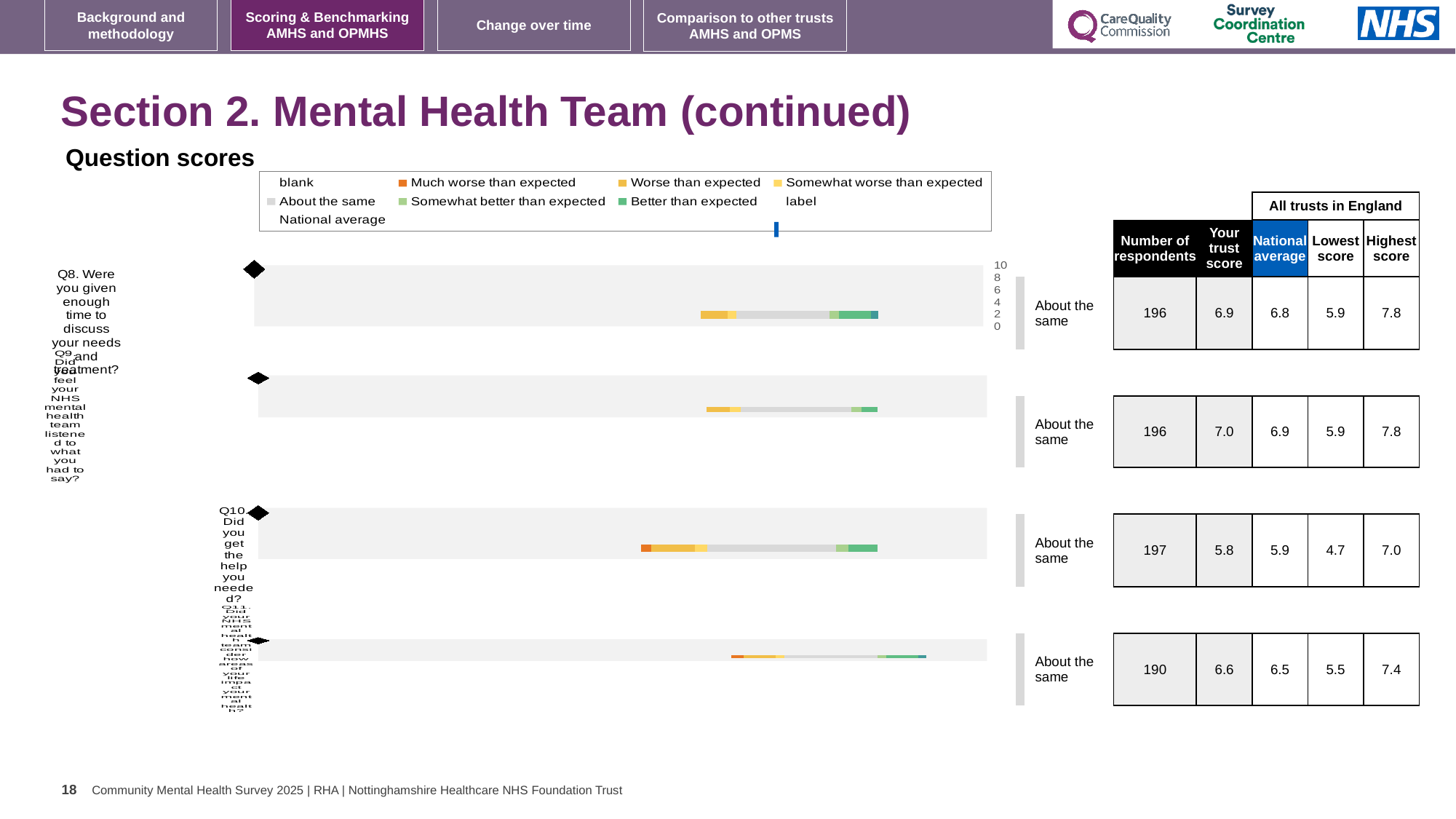
What kind of chart is used to show the Q8 question score? bar chart For the Q10 chart, which is larger: the trust score or the National average? National average In the legend, what colour represents "Much worse than expected"? orange How many question bar charts are shown on the slide? 4 Which question chart has the lowest "Your trust score"? Q10 Which question chart has the highest "Your trust score"? Q9 For the Q9 chart, what is the Highest score among all trusts in England? 7.8 For the Q11 chart, what is the number of respondents? 190 For the Q8 chart, what is the "Your trust score" value? 6.9 For the Q10 chart, what is the National average score? 5.9 In the legend, what colour represents "Better than expected"? green For the Q8 chart, what is the difference between the Highest score and the Lowest score? 1.9